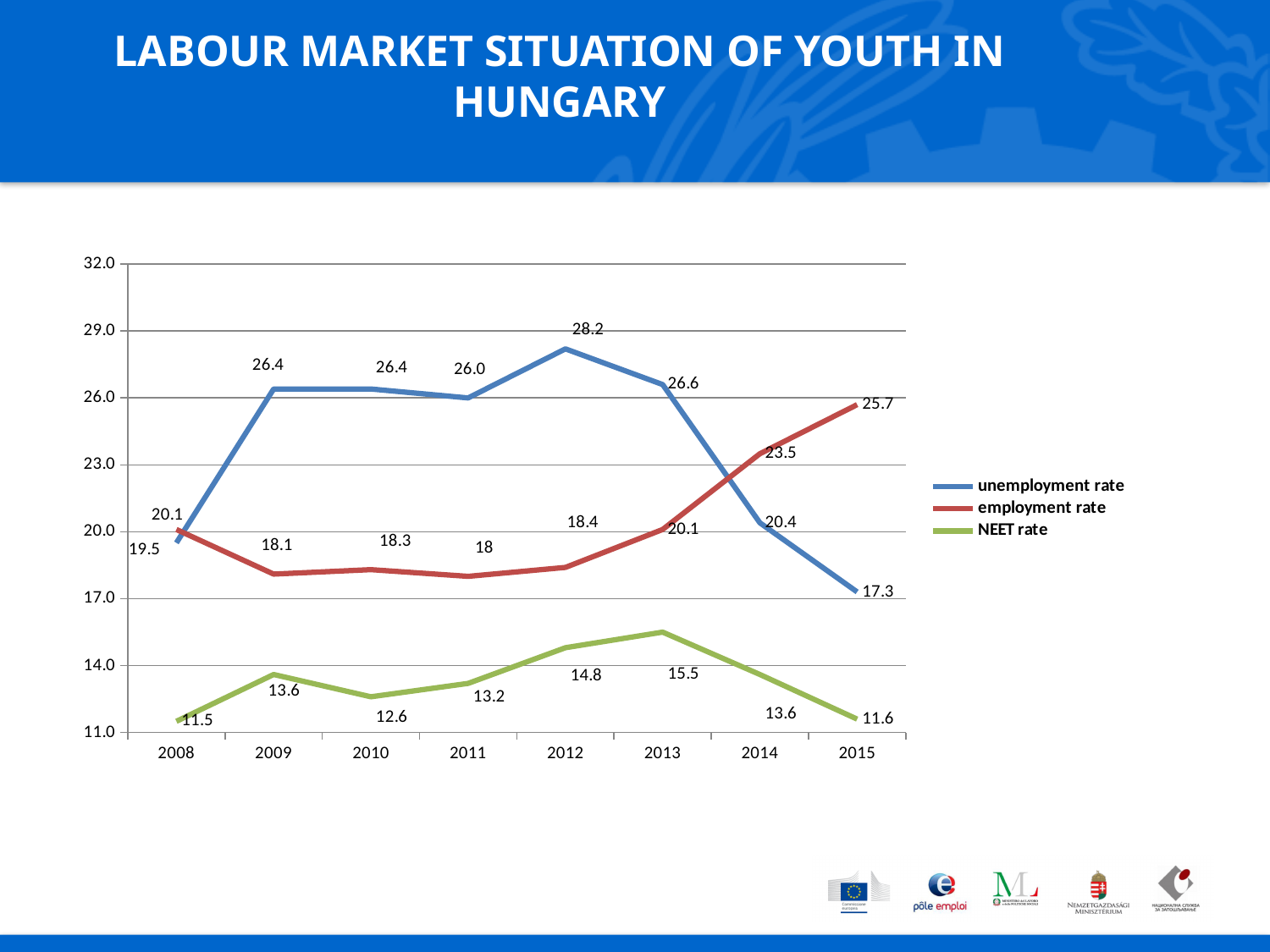
How did the employment rate change from 2013 to 2015? it rose What was the NEET rate in 2013? 15.5 How many series does the legend list? 3 Which colour is used for the NEET rate line? green Which was higher in 2015, the unemployment rate or the employment rate? employment rate What is the difference between the unemployment rate in 2012 and in 2015? 10.9 What type of chart is shown on the slide? line chart How many years are shown on the x axis? 8 In which year was the NEET rate lowest? 2008 What was the employment rate in 2015? 25.7 In which year was the unemployment rate highest? 2012 What was the unemployment rate in 2012? 28.2